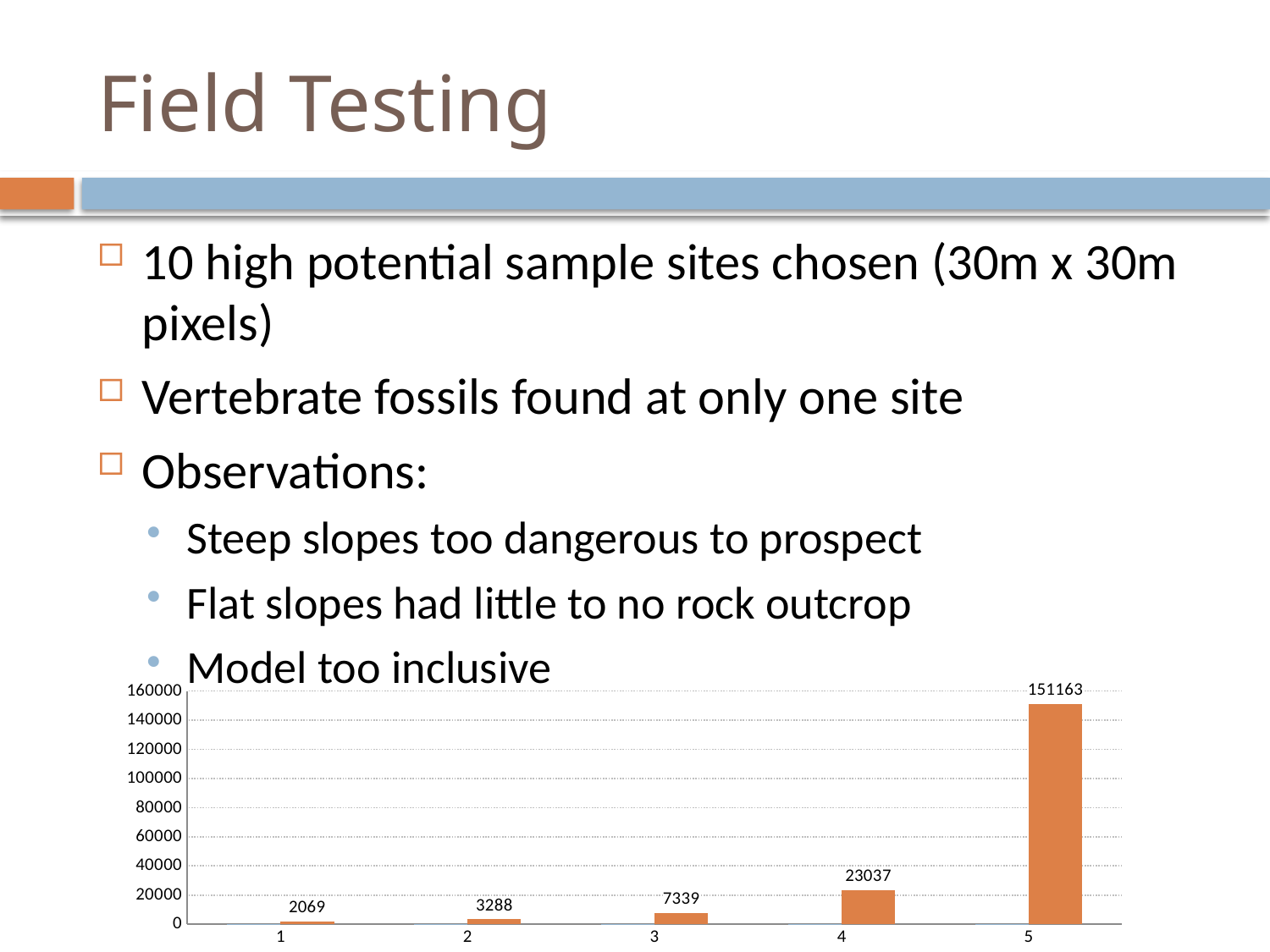
Is the value for category 5 greater or less than 140000? greater What is the difference between the values for category 2 and category 1? 1219 What is the difference between the values for category 5 and category 4? 128126 Do the values rise or fall from category 1 to category 5? rise What kind of chart is shown on the slide? bar chart What is the value for category 5? 151163 Which category has the lowest value? 1 What is the value for category 3? 7339 What is the value for category 1? 2069 Which category has the highest value? 5 Which is larger, the value for category 3 or the value for category 4? 4 How many categories are shown on the x axis? 5